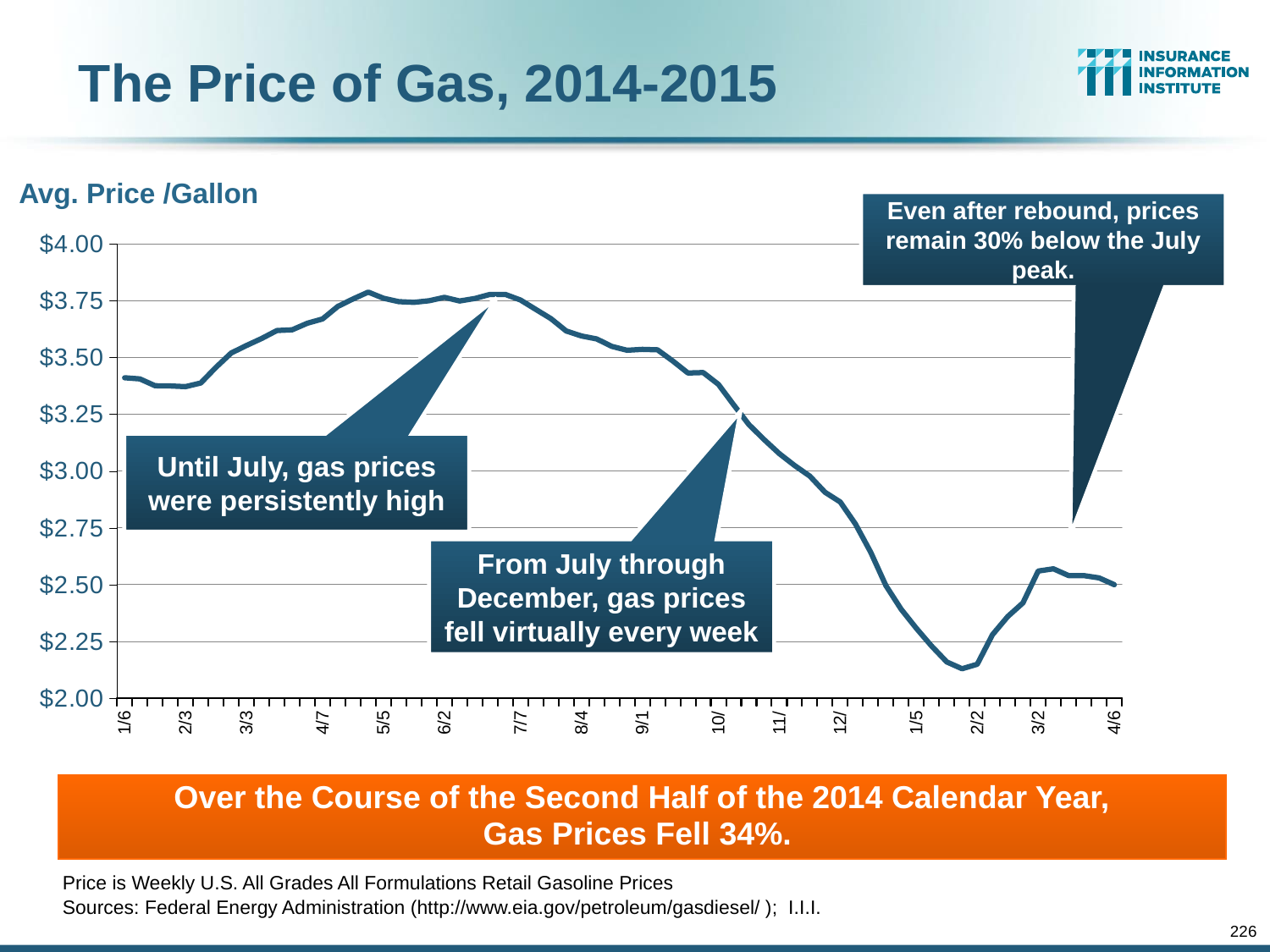
Do gas prices rise or fall between 7/7 and 12/? fall What label is shown above the y axis of the chart? Avg. Price /Gallon What is the title of the chart on the slide? The Price of Gas, 2014-2015 What kind of chart is shown on the slide? Line chart Is the value at 4/6 greater or less than $2.25? greater Is the value at 2/2 greater or less than $2.25? less Is the value at 7/7 greater or less than $3.50? greater Which is larger, the value at 1/6 or the value at 4/6? 1/6 How many date labels are shown on the x axis? 16 Which is larger, the value at 7/7 or the value at 2/2? 7/7